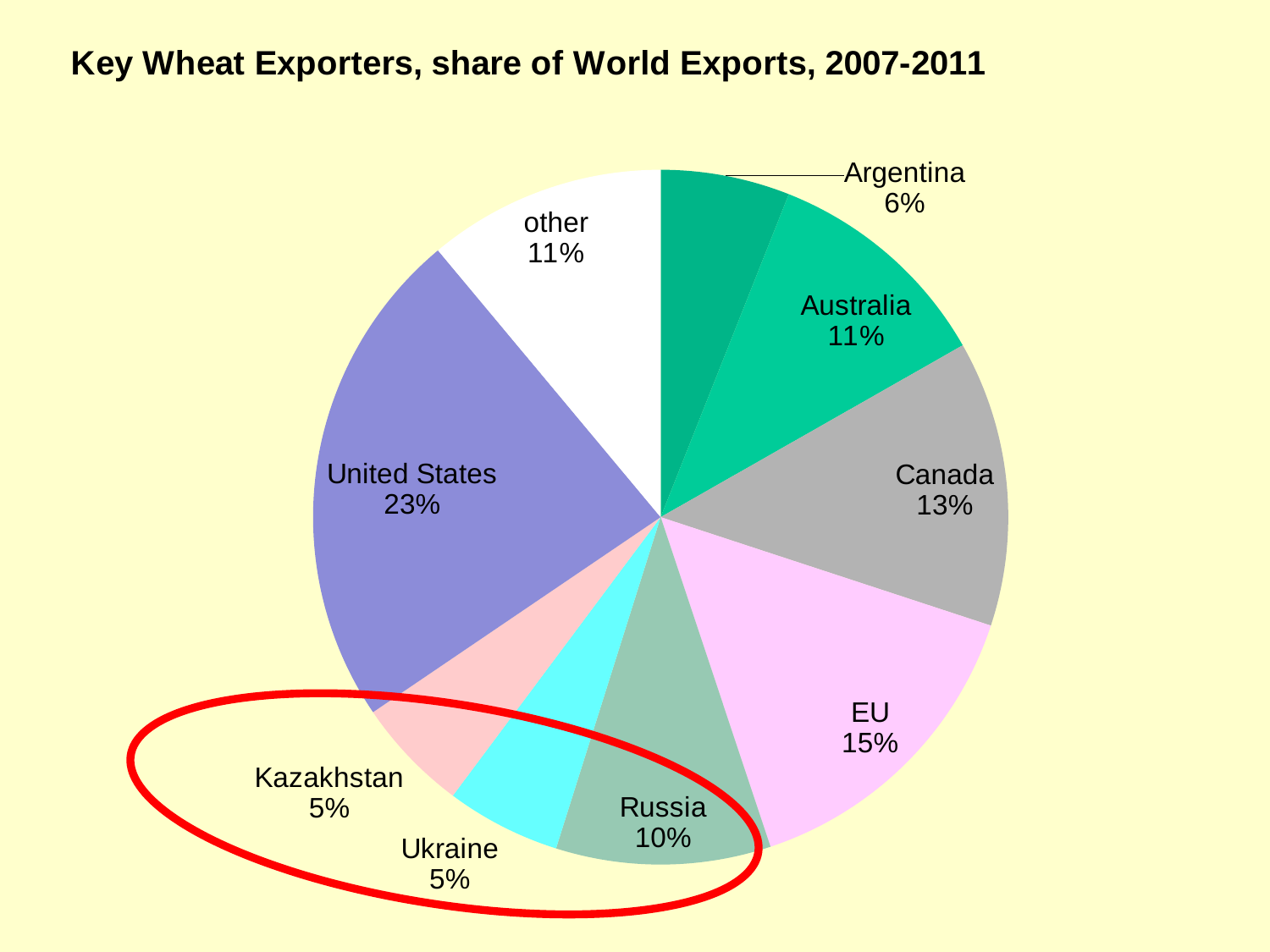
Which has a larger share of world wheat exports, Canada or Australia? Canada How much larger is the EU's share than Russia's share? 5 percentage points What share of world exports is shown for Russia? 10% What type of chart is shown on the slide? Pie chart How many slices does the pie chart have? 9 What is the share shown for Argentina? 6% What is the combined share of Kazakhstan, Ukraine and Russia? 20% Which exporter has the largest share of world wheat exports in the chart? United States What is the title of the chart? Key Wheat Exporters, share of World Exports, 2007-2011 What is the share shown for Canada? 13% What share of world wheat exports does the United States hold according to the pie chart? 23% Which named country has the smallest share in the chart? Ukraine and Kazakhstan (tied at 5%)